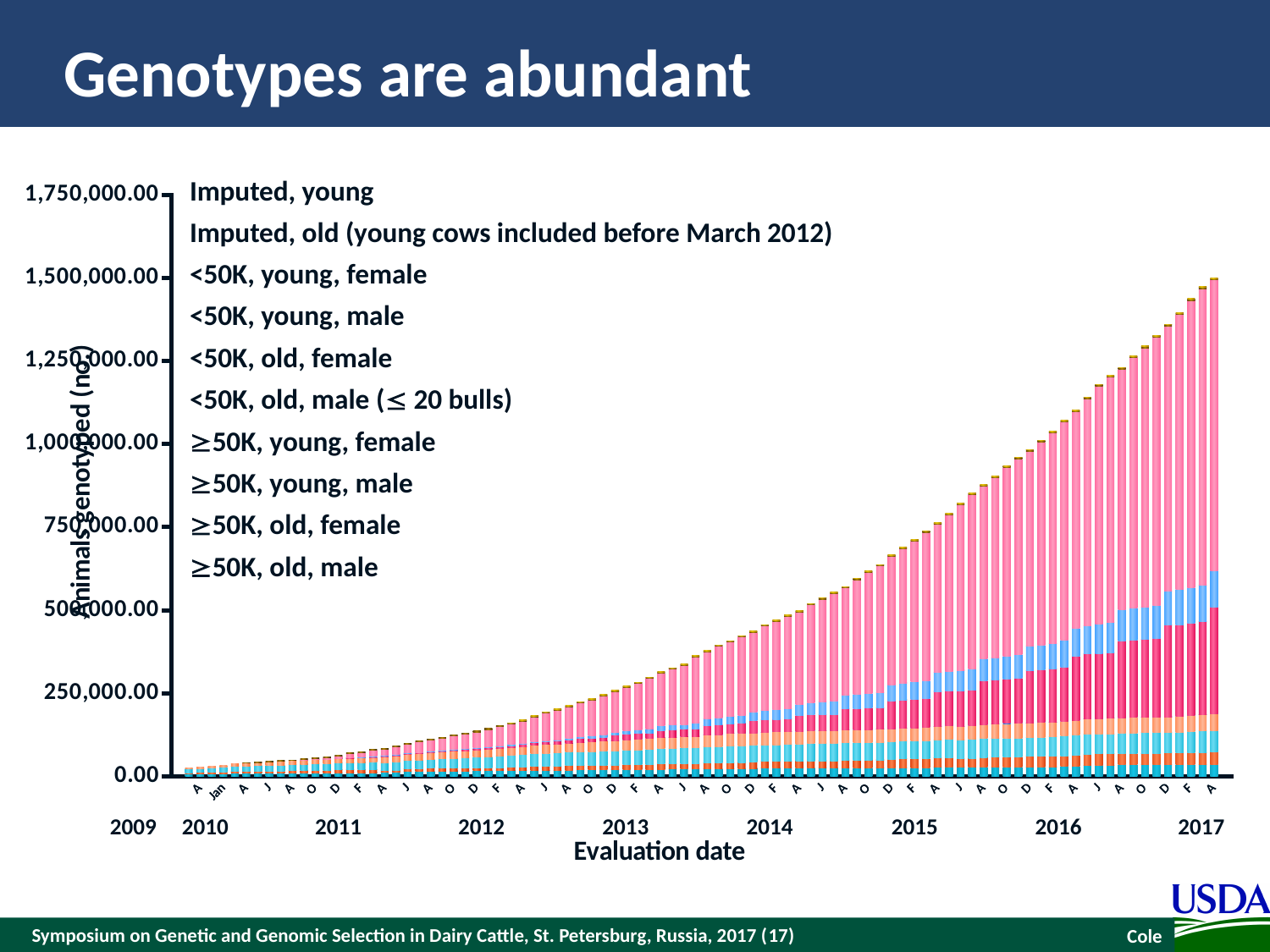
What kind of chart is shown on the slide? stacked bar chart How many series does the legend list? 10 What is the label of the x axis? Evaluation date Which year's bar is the tallest on the chart? 2017 Is the total for the bar at 2016 larger or smaller than the total for the bar at 2014? larger Do the total animals genotyped rise or fall along the x axis from 2009 to 2017? rise Which year's bar is the shortest on the chart? 2009 Is the total for the bar at 2016 greater or less than 750,000.00? greater What is the title of the slide containing the chart? Genotypes are abundant Is the total for the bar at 2012 greater or less than 250,000.00? less Is the total for the last bar (2017) greater or less than 1,250,000.00? greater